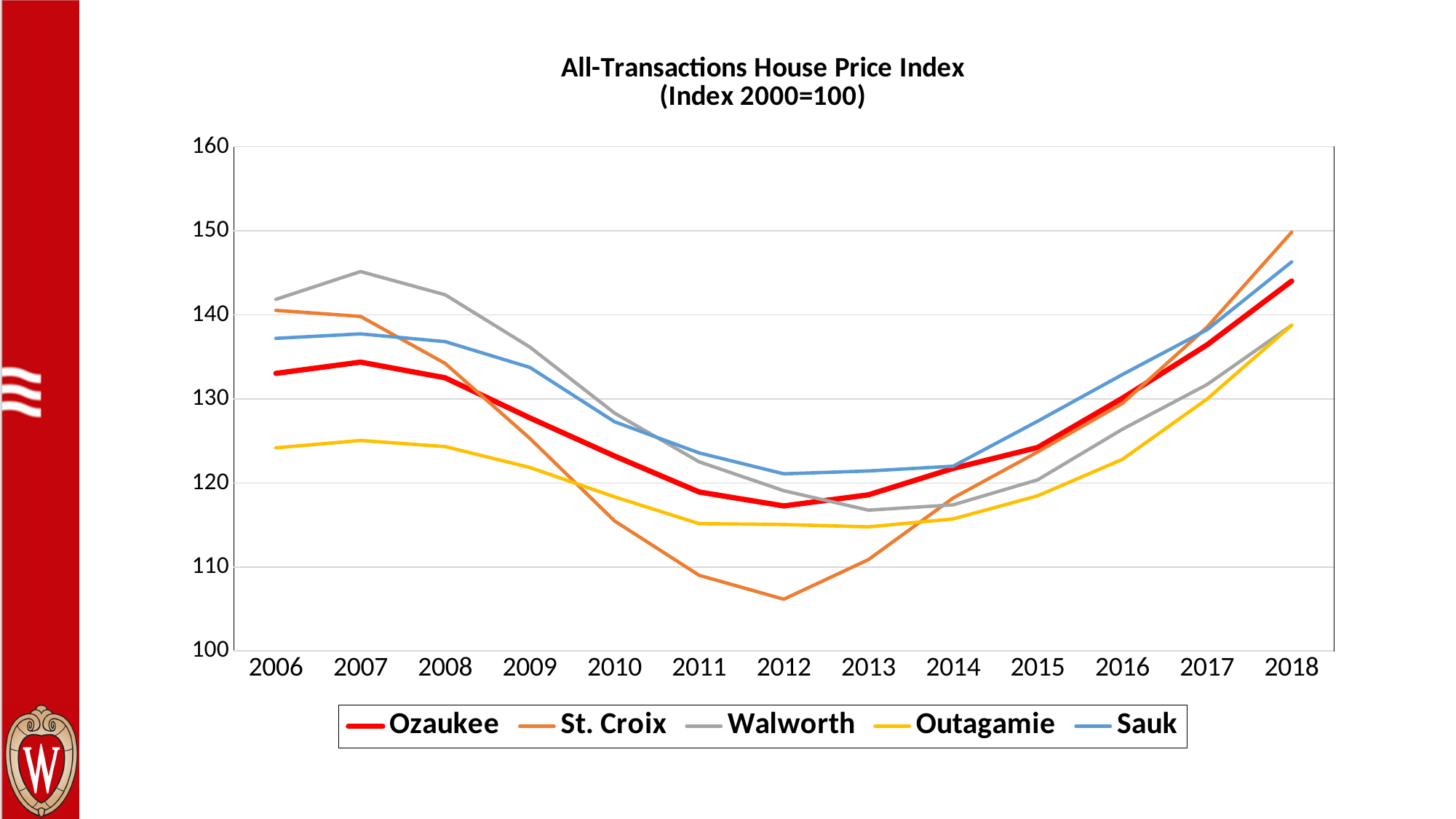
How many years are shown along the x axis? 13 Which series has the lowest value in 2006? Outagamie Is the value for St. Croix in 2012 greater or less than 110? less What kind of chart is shown on the slide? line chart Which series has the highest value in 2007? Walworth Which series has the lowest value in 2012? St. Croix How many series does the legend list? 5 Is the value for Outagamie in 2006 greater or less than 120? greater Which series has the highest value in 2018? St. Croix Does the Ozaukee line rise or fall from 2012 to 2018? rise In 2010, which is larger, the value for Sauk or the value for Outagamie? Sauk Is the value for Walworth in 2007 greater or less than 140? greater